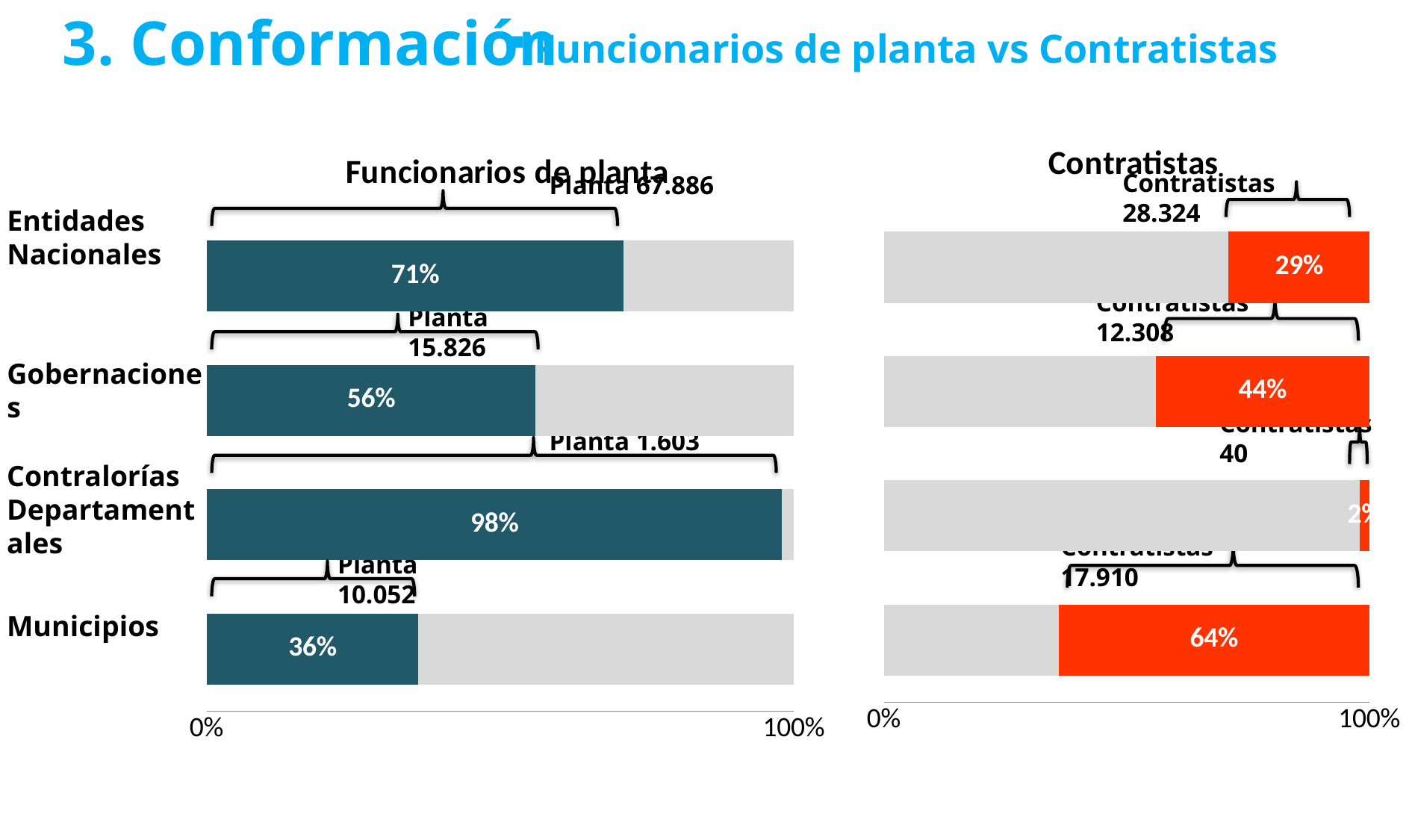
How many categories are shown in the Contratistas chart? 4 In the Contratistas chart, what is the value for Municipios? 64% In the Funcionarios de planta chart, what number is shown in the bracket label above the Municipios bar? Planta 10.052 In the Contratistas chart, what is the difference between the values for Municipios and Entidades Nacionales? 35% In the Funcionarios de planta chart, which category has the highest value? Contralorías Departamentales In the Funcionarios de planta chart, which category has the lowest value? Municipios What kind of chart is the Funcionarios de planta chart? Bar chart In the Funcionarios de planta chart, which is larger: the value for Entidades Nacionales or the value for Gobernaciones? Entidades Nacionales In the Contratistas chart, what is the value for Gobernaciones? 44% In the Funcionarios de planta chart, what is the value for Entidades Nacionales? 71% In the Funcionarios de planta chart, what is the value for Gobernaciones? 56% In the Contratistas chart, which category has the lowest value? Contralorías Departamentales